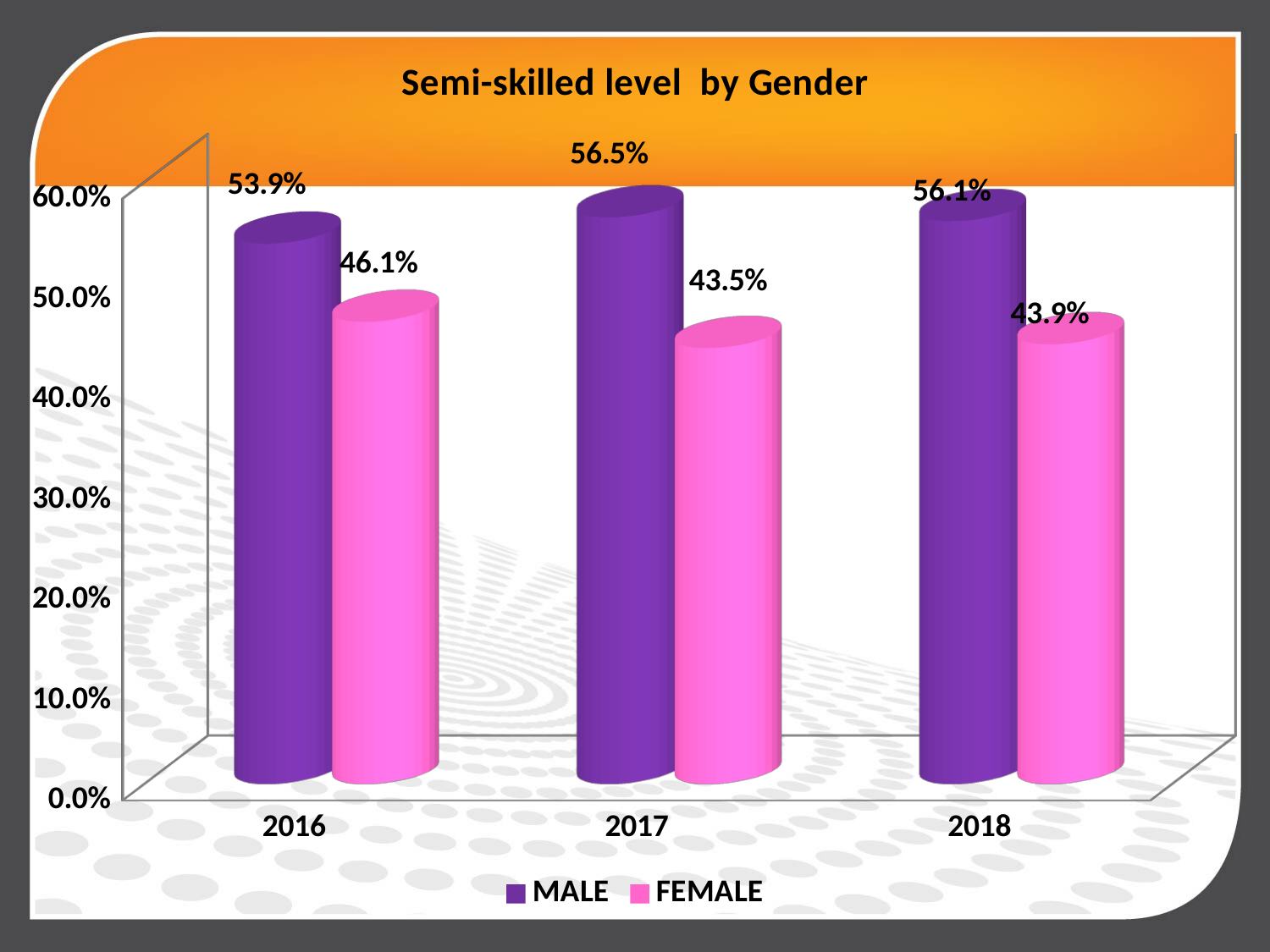
What is the FEMALE value for 2018? 43.9% In which year is the FEMALE value lowest? 2017 What is the FEMALE value for 2016? 46.1% What is the MALE value for 2017? 56.5% What is the title of the chart? Semi-skilled level by Gender How many series does the legend list? 2 What is the difference between the MALE and FEMALE values in 2018? 12.2% Which is larger in 2016, the MALE value or the FEMALE value? MALE What kind of chart is shown on the slide? Bar chart How many years are shown on the x axis? 3 In which year is the MALE value highest? 2017 What is the MALE value for 2016? 53.9%